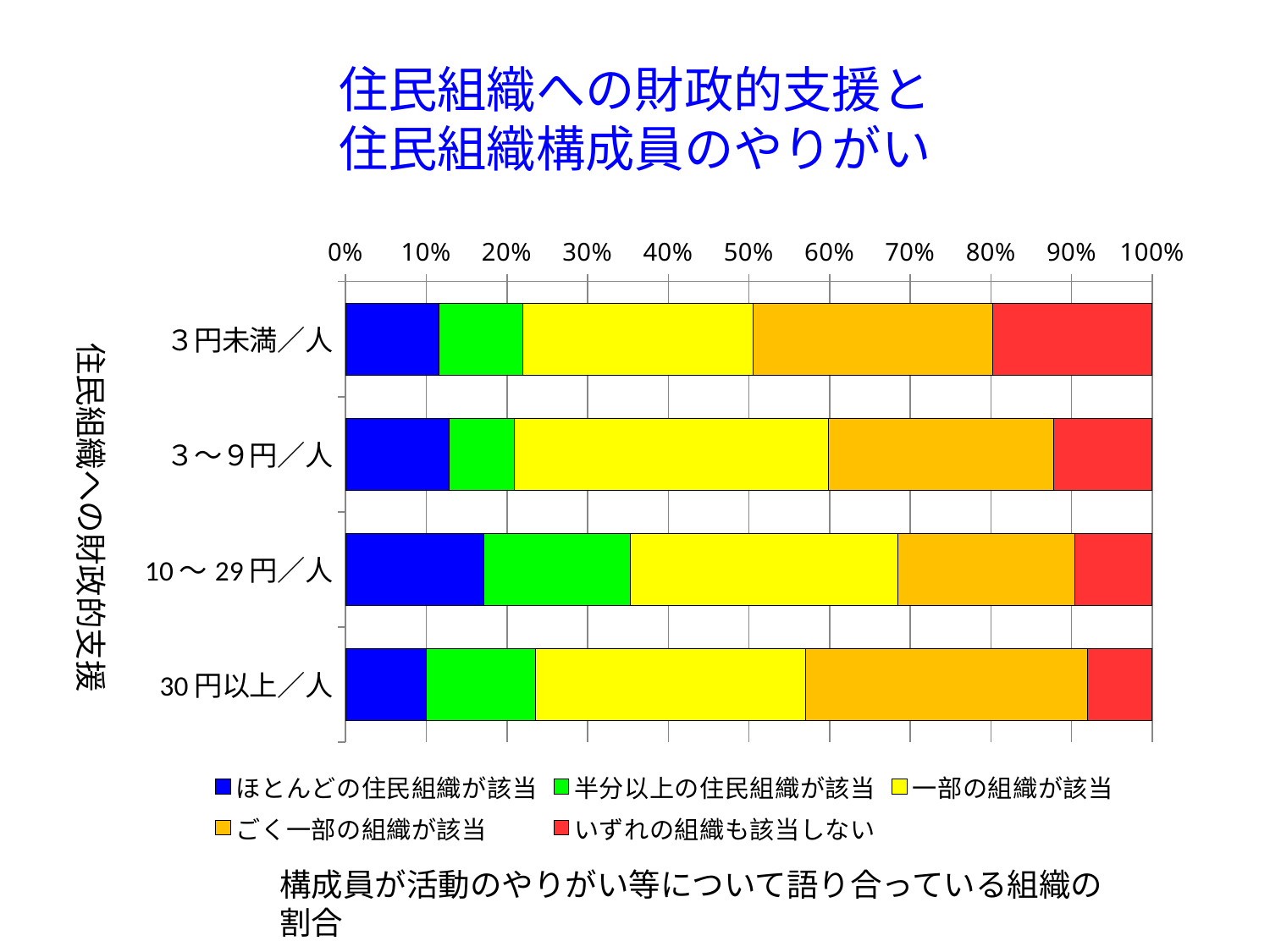
How many categories (financial support levels) are shown on the vertical axis? 4 What kind of chart is shown on the slide? Stacked bar chart Which is larger: the red (いずれの組織も該当しない) share for 3円未満／人 or for 30円以上／人? 3円未満／人 Which category has the largest blue (ほとんどの住民組織が該当) segment? 10～29円／人 Which category has the largest red (いずれの組織も該当しない) segment? 3円未満／人 What is the title of the chart? 住民組織への財政的支援と住民組織構成員のやりがい Which legend entry is shown in blue? ほとんどの住民組織が該当 Is the red (いずれの組織も該当しない) share for 3円未満／人 greater or less than 10%? greater Which is larger: the green (半分以上の住民組織が該当) share for 10～29円／人 or for 3～9円／人? 10～29円／人 Is the blue (ほとんどの住民組織が該当) share for 10～29円／人 greater or less than 10%? greater Which category has the largest green (半分以上の住民組織が該当) segment? 10～29円／人 How many series does the legend list? 5